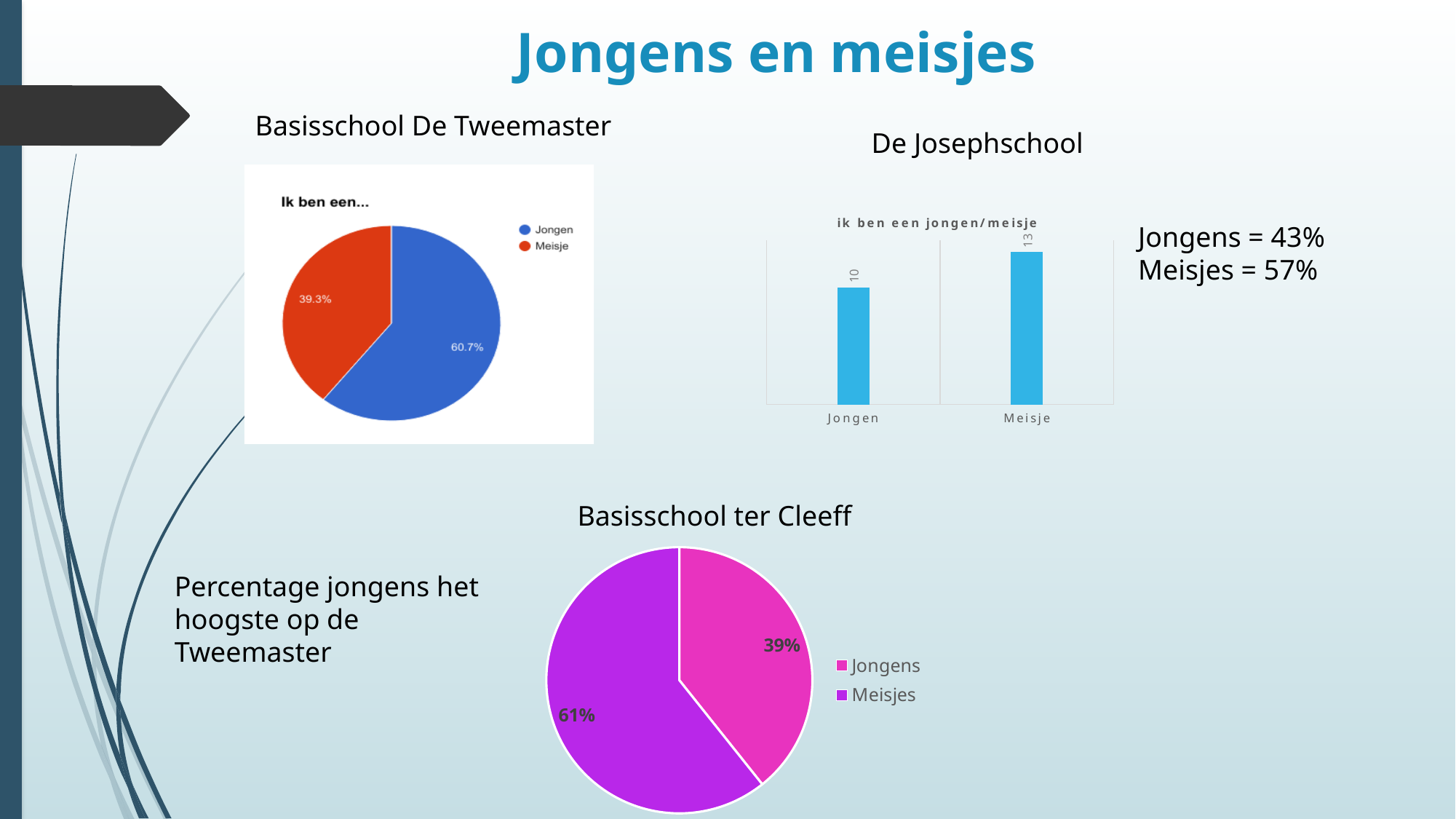
In the De Josephschool chart, what is the value for Jongen? 10 In the Basisschool De Tweemaster chart, which category has the larger share? Jongen In the Basisschool De Tweemaster chart, what percentage is shown for Jongen? 60.7% In the De Josephschool chart, what is the difference between the Meisje and Jongen values? 3 How many entries does the legend of the Basisschool ter Cleeff chart list? 2 How many categories does the De Josephschool chart show? 2 What kind of chart is the Basisschool De Tweemaster chart? Pie chart In the Basisschool De Tweemaster chart, what percentage is shown for Meisje? 39.3% In the De Josephschool chart, what is the value for Meisje? 13 What kind of chart is the De Josephschool chart? Bar chart In the Basisschool ter Cleeff chart, what percentage is shown for Meisjes? 61% In the Basisschool ter Cleeff chart, what percentage is shown for Jongens? 39%